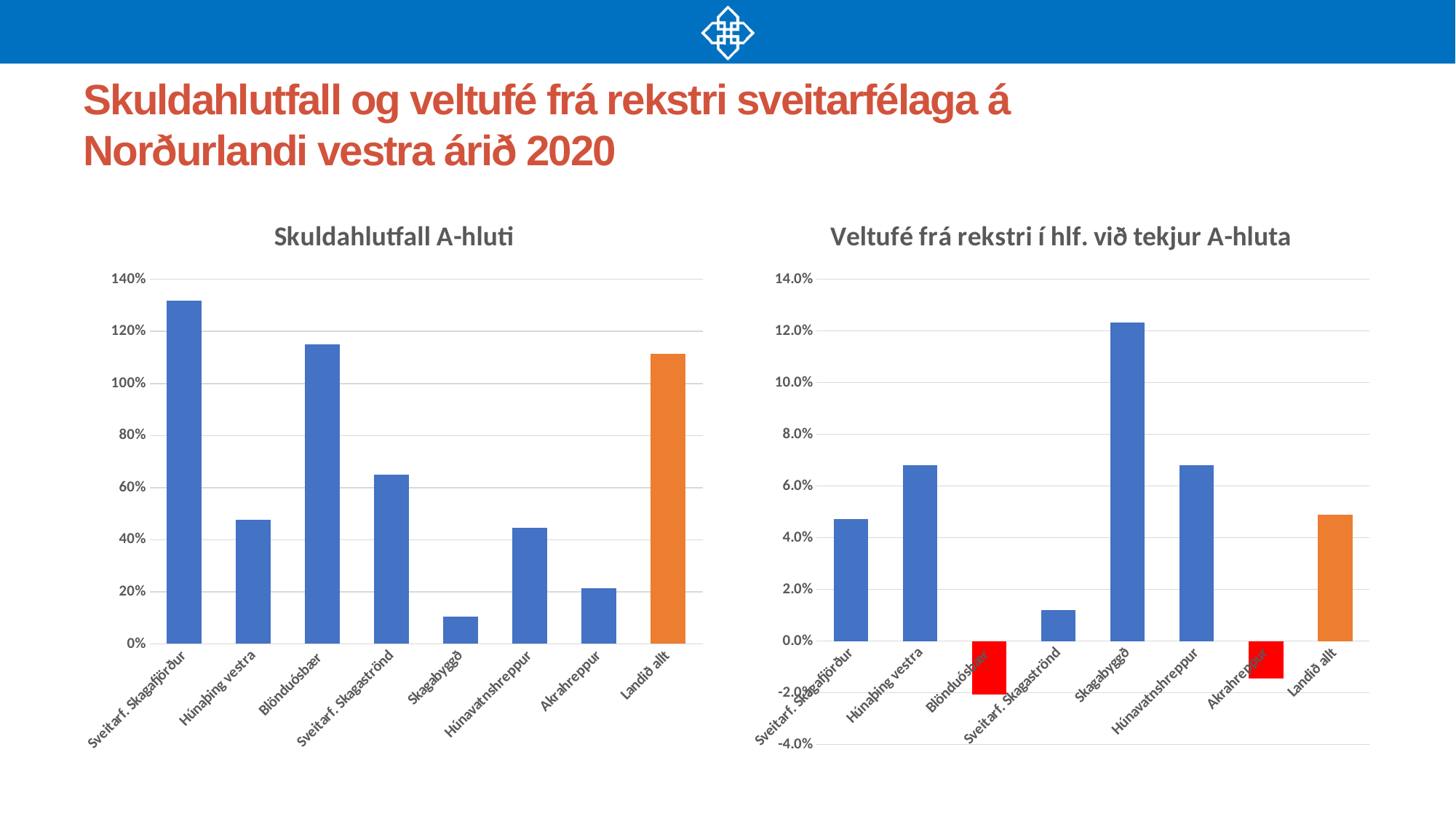
In the chart titled "Veltufé frá rekstri í hlf. við tekjur A-hluta", which category has the highest value? Skagabyggð In the chart titled "Skuldahlutfall A-hluti", is the value for Blönduósbær greater or less than 100%? greater In the chart titled "Veltufé frá rekstri í hlf. við tekjur A-hluta", is the value for Sveitarf. Skagaströnd greater or less than 2.0%? less In the chart titled "Skuldahlutfall A-hluti", which category has the highest value? Sveitarf. Skagafjörður How many categories are shown in the chart titled "Skuldahlutfall A-hluti"? 8 In the chart titled "Skuldahlutfall A-hluti", is the value for Akrahreppur greater or less than 40%? less In the chart titled "Veltufé frá rekstri í hlf. við tekjur A-hluta", which is larger, the value for Landið allt or the value for Akrahreppur? Landið allt In the chart titled "Veltufé frá rekstri í hlf. við tekjur A-hluta", which category has the lowest value? Blönduósbær In the chart titled "Skuldahlutfall A-hluti", which is larger, the value for Sveitarf. Skagaströnd or the value for Húnaþing vestra? Sveitarf. Skagaströnd What kind of chart is the chart on the right of the slide? Bar chart In the chart titled "Skuldahlutfall A-hluti", which category has the lowest value? Skagabyggð